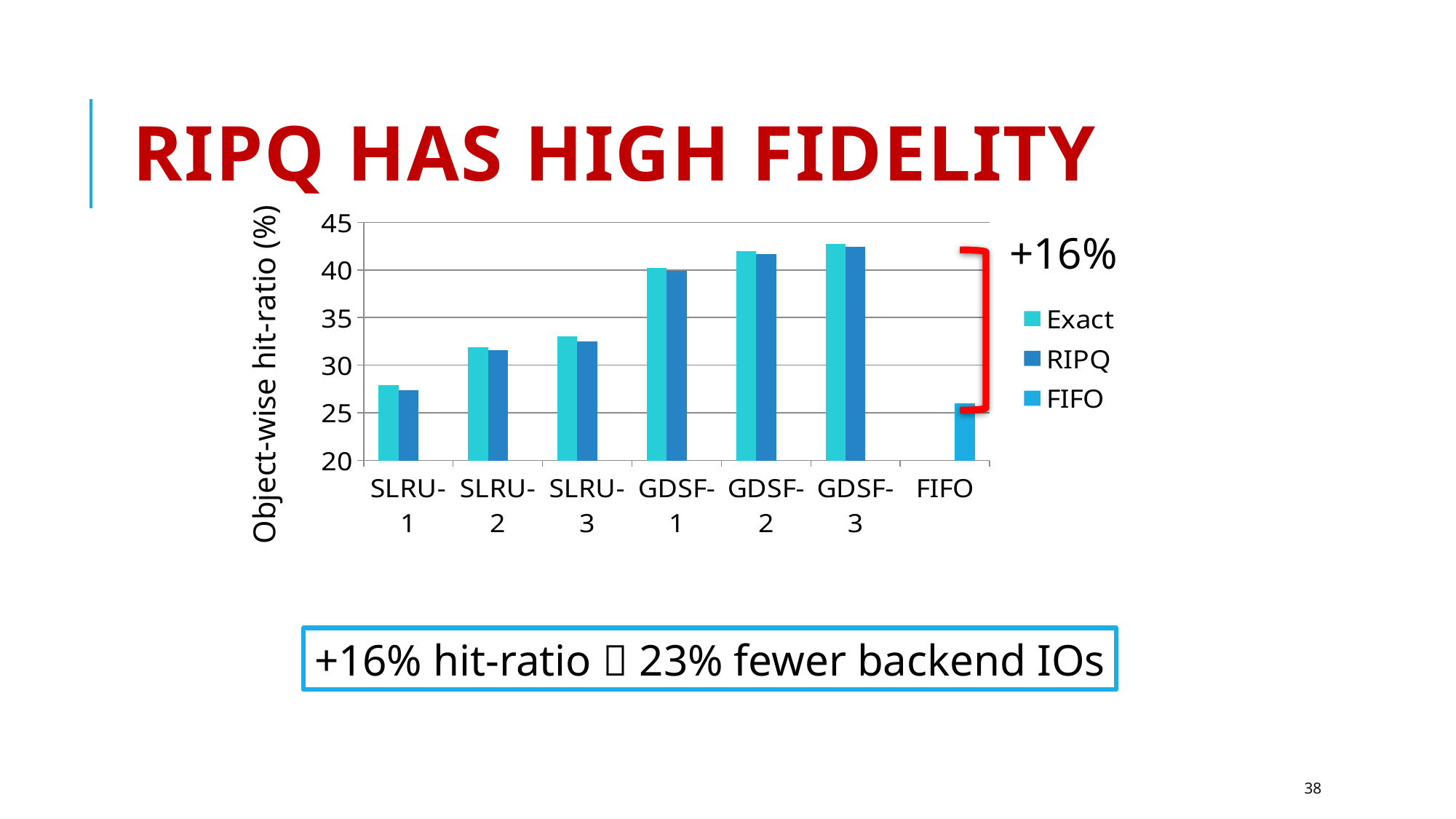
Is the FIFO value greater or less than 25? greater What percentage improvement is annotated next to the red bracket on the chart? +16% Do the Exact values rise or fall going from SLRU-1 to GDSF-3 along the x axis? rise Is the Exact value for SLRU-3 greater or less than 35? less Which category has the lowest Exact bar in the chart? SLRU-1 What kind of chart is shown on the slide? bar chart Which is larger, the Exact value for SLRU-3 or the Exact value for GDSF-1? GDSF-1 How many categories are shown along the x axis of the chart? 7 Is the RIPQ value for SLRU-1 greater or less than 30? less How many series does the chart's legend list? 3 What is the label of the chart's y axis? Object-wise hit-ratio (%)